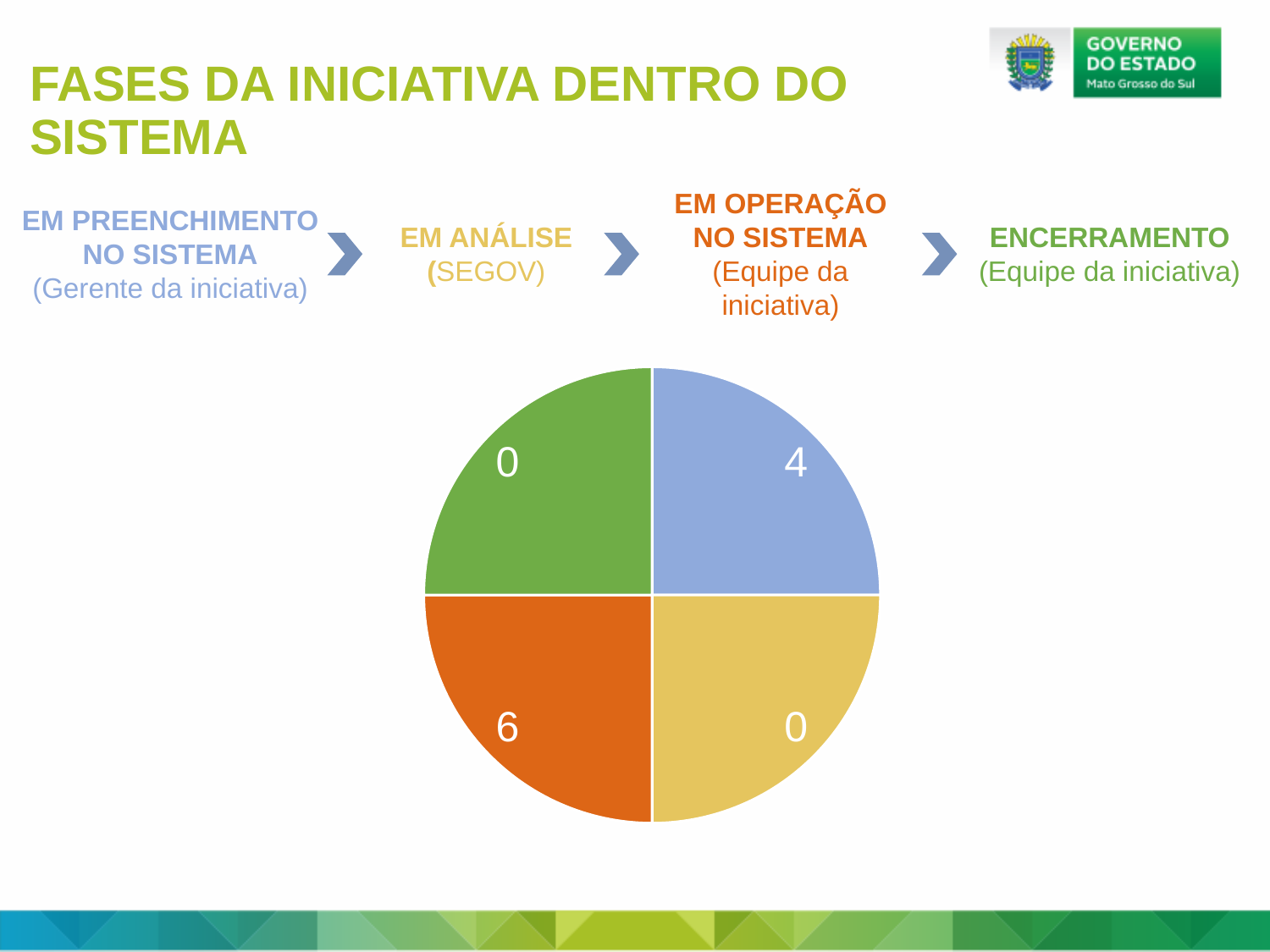
What kind of chart is shown on the slide? pie chart What is the total of all the values shown on the pie chart? 10 Which slice of the pie chart has the highest value? the orange slice (6) What value is shown on the orange slice of the pie chart? 6 How many slices of the pie chart show a value of 0? 2 What value is shown on the blue slice of the pie chart? 4 How many slices does the pie chart have? 4 What is the difference between the values on the orange slice and the blue slice? 2 Which is larger, the value on the blue slice or the value on the orange slice? the orange slice What is the title of the slide containing the pie chart? FASES DA INICIATIVA DENTRO DO SISTEMA What value is shown on the yellow slice of the pie chart? 0 What value is shown on the green slice of the pie chart? 0